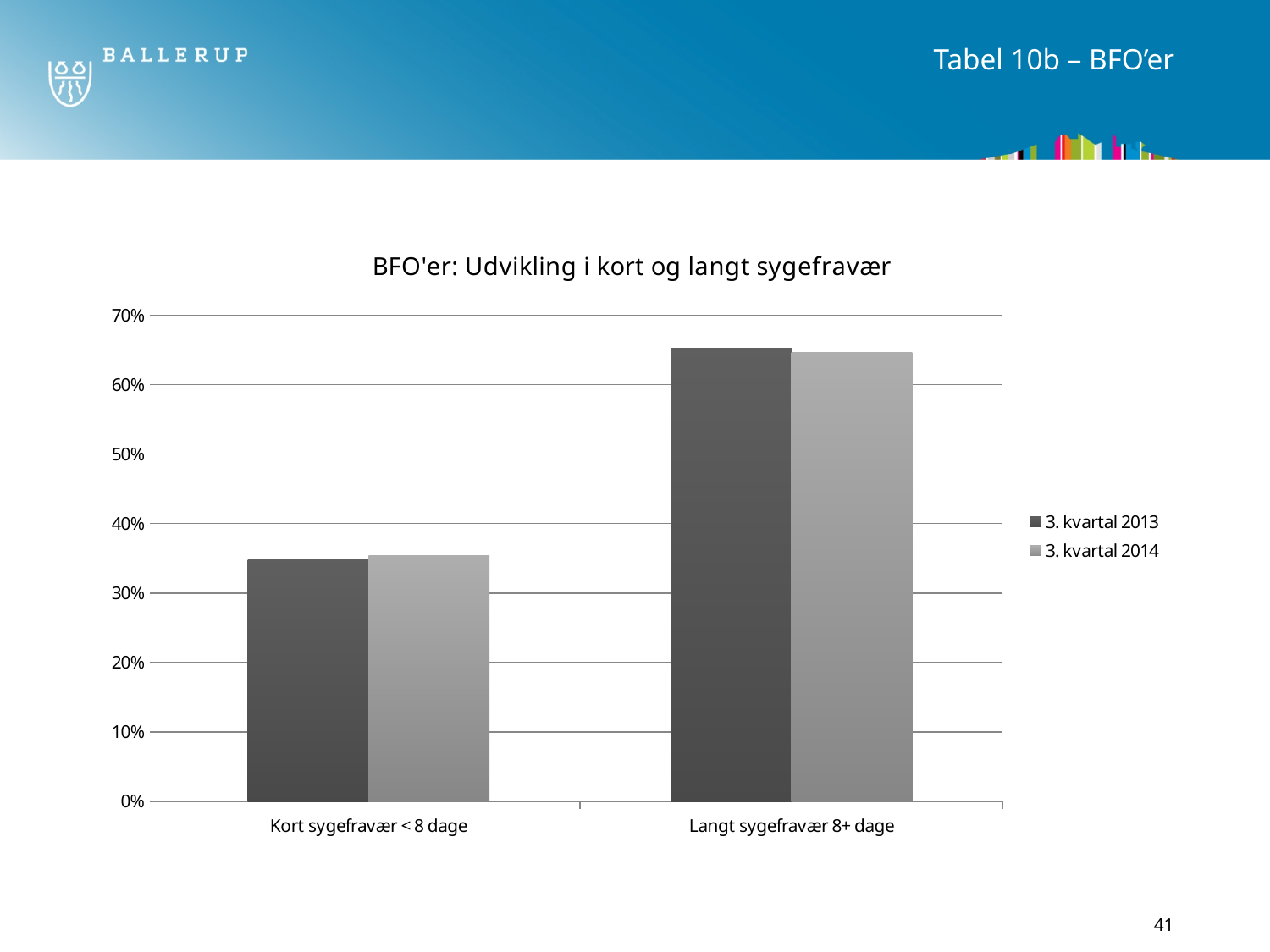
Which category has the lowest bars? Kort sygefravær < 8 dage How many categories are shown on the x axis? 2 Is the value for Kort sygefravær < 8 dage in 3. kvartal 2014 greater or less than 40%? less How many series does the legend list? 2 Is the value for Langt sygefravær 8+ dage in 3. kvartal 2013 greater or less than 60%? greater Which category has the highest bars? Langt sygefravær 8+ dage Is the value for Kort sygefravær < 8 dage in 3. kvartal 2013 greater or less than 30%? greater What is the title of the chart? BFO'er: Udvikling i kort og langt sygefravær What type of chart is shown on the slide? bar chart For 3. kvartal 2014, which is larger: Kort sygefravær < 8 dage or Langt sygefravær 8+ dage? Langt sygefravær 8+ dage Which series are listed in the legend? 3. kvartal 2013 and 3. kvartal 2014